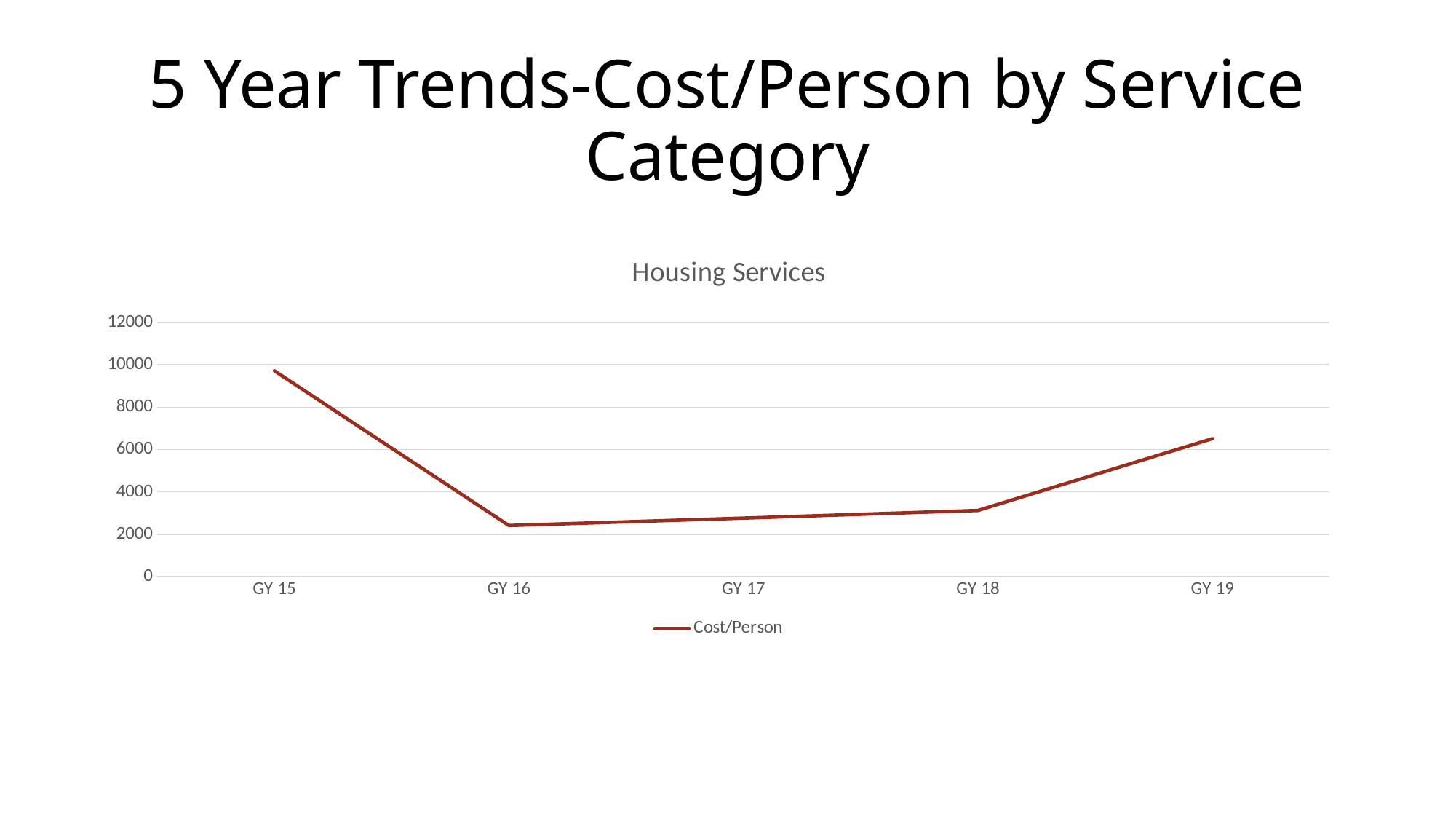
Is the Cost/Person for GY 15 greater or less than 8000? greater How many years are plotted along the x axis? 5 How many series does the legend list? 1 Which year has the lowest Cost/Person? GY 16 Does the Cost/Person rise or fall from GY 15 to GY 16? fall Is the Cost/Person for GY 16 greater or less than 4000? less What kind of chart is shown on the slide? line chart What is the title of the chart? Housing Services Is the Cost/Person for GY 19 greater or less than 6000? greater Which is larger, the Cost/Person for GY 15 or for GY 19? GY 15 What is the name of the series shown in the legend? Cost/Person Which year has the highest Cost/Person? GY 15